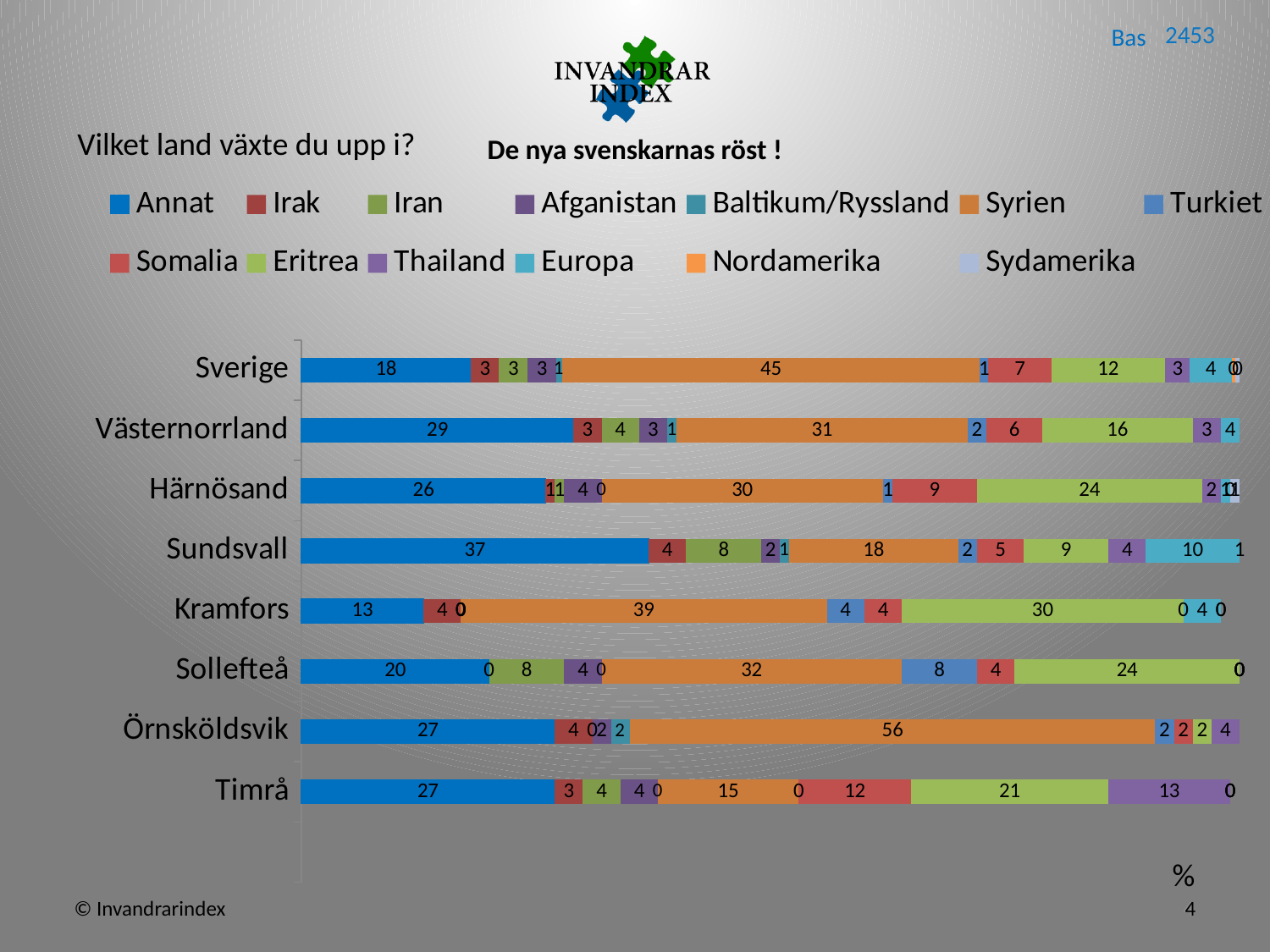
What is the value for Thailand in Timrå? 13 Which region has the lowest value for Annat? Kramfors What is the value for Syrien in Örnsköldsvik? 56 What is the difference between the Syrien value for Sverige and for Västernorrland? 14 How many series does the legend list? 13 What is the value for Eritrea in Kramfors? 30 Which region has the highest value for Syrien? Örnsköldsvik What kind of chart is shown on the slide? stacked bar chart How many regions (categories) are plotted on the chart? 8 What is the value for Annat in Sundsvall? 37 Which has the larger Eritrea value, Kramfors or Härnösand? Kramfors What is the title question shown above the chart? Vilket land växte du upp i?